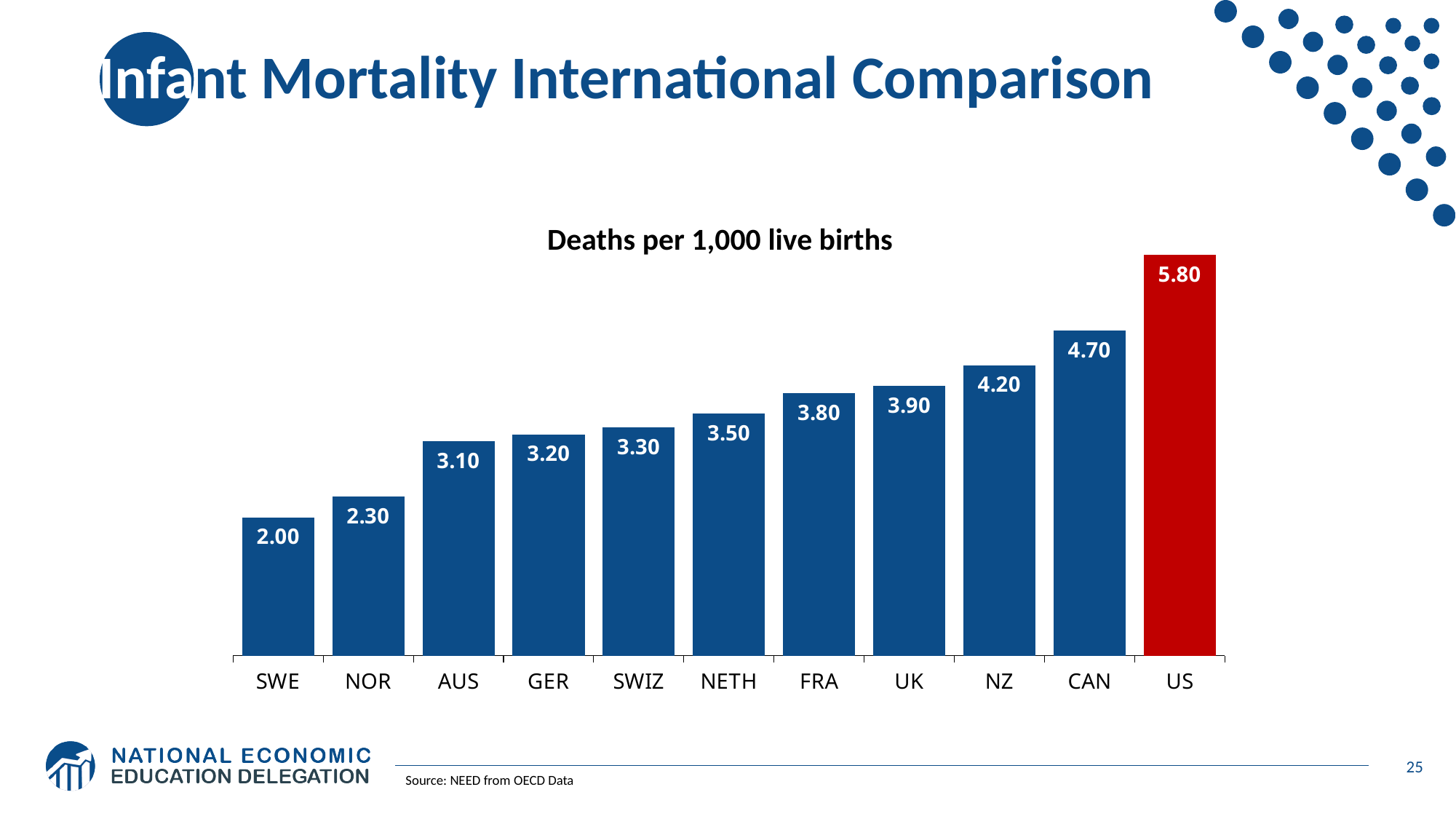
What is the difference between the values for NZ and SWE? 2.20 Which has a larger value, UK or GER? UK Which country has the highest value? US What is the value for the US? 5.80 Which country has the lowest value? SWE Do the values rise or fall from left to right across the x axis? Rise What is the difference between the values for the US and CAN? 1.10 How many countries are shown in the chart? 11 What is the value for SWE? 2.00 What is the value for FRA? 3.80 What is the title of the chart? Deaths per 1,000 live births What kind of chart is shown on the slide? Bar chart